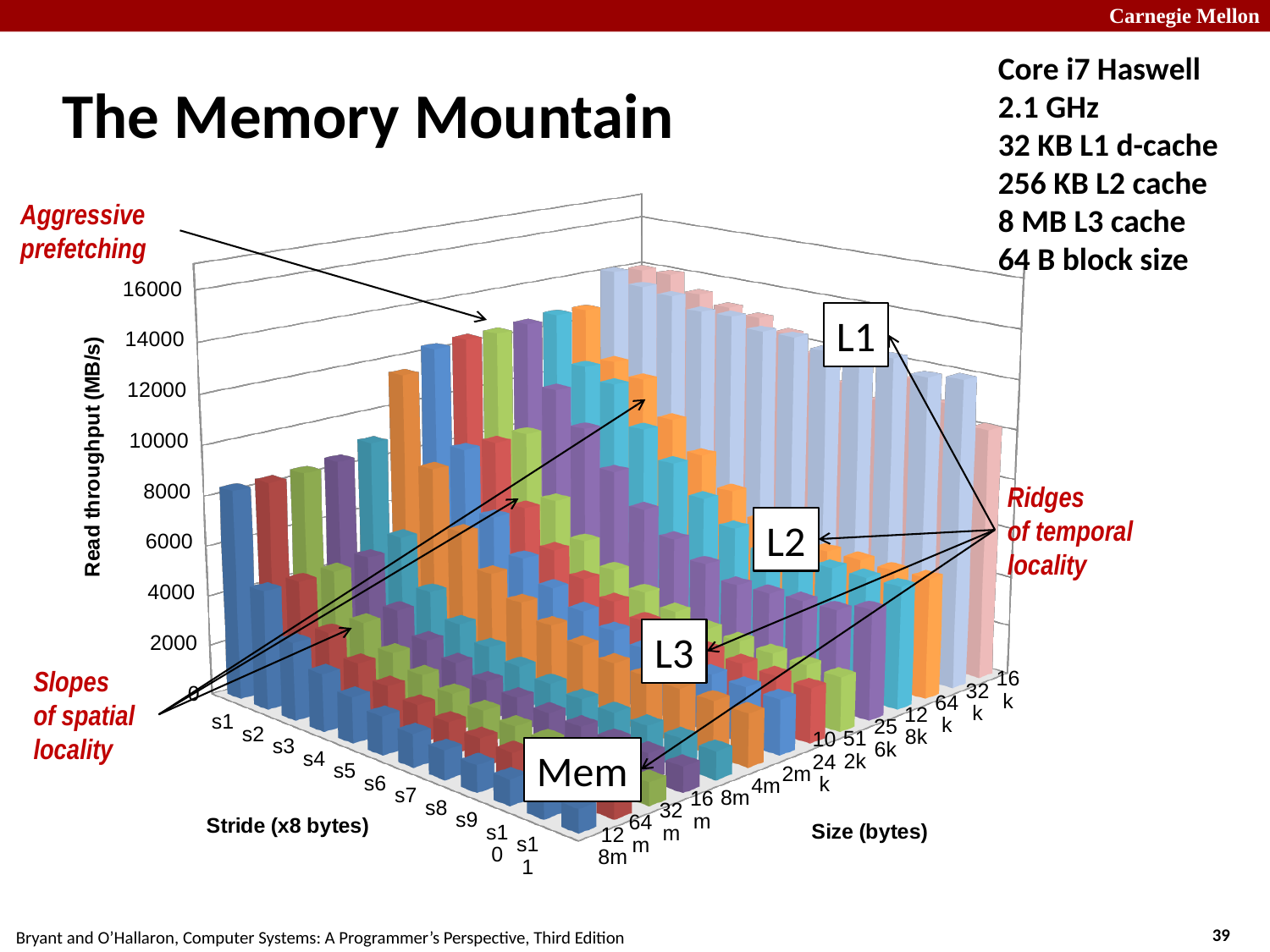
Is the read throughput for stride s1 at size 16k greater or less than 12000? greater Is the read throughput for stride s11 at size 8m greater or less than 4000? less What is the label on the vertical axis of the chart? Read throughput (MB/s) How many stride categories (s1, s2, ...) are shown along the stride axis? 11 What is the highest tick value shown on the read throughput axis? 16000 For a fixed size, do the read throughput values rise or fall as the stride increases from s1 to s11? fall What kind of chart is shown on the slide? bar chart What is the title of the slide's chart? The Memory Mountain